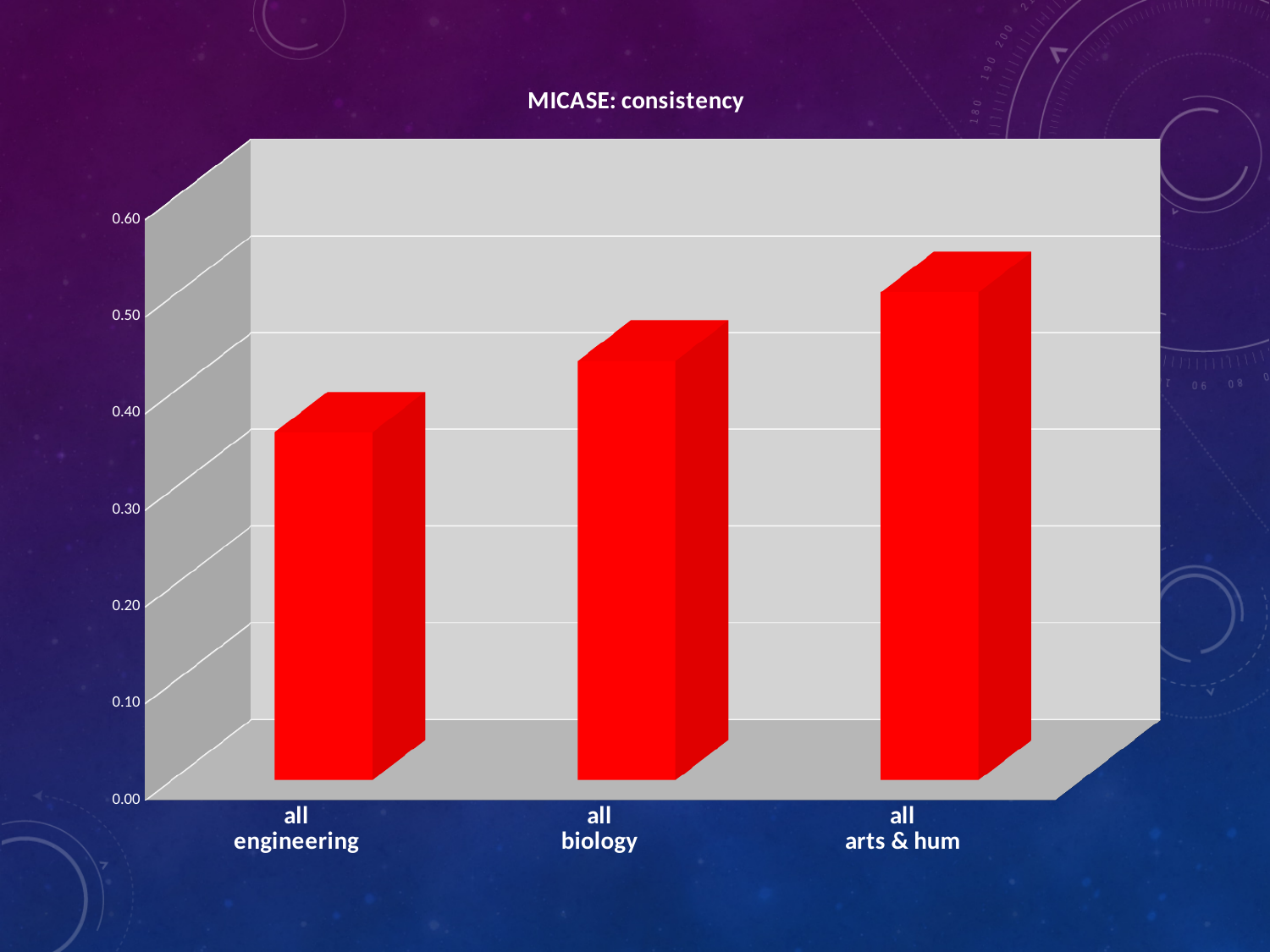
Is the value for all arts & hum greater or less than 0.60? less Which is larger, the value for all biology or the value for all engineering? all biology Which category has the lowest value? all engineering Is the value for all biology greater or less than 0.40? greater What kind of chart is shown on the slide? bar chart Is the value for all engineering greater or less than 0.30? greater What is the title of the chart? MICASE: consistency How many categories are plotted in the chart? 3 Which category has the highest value? all arts & hum Do the values rise or fall from left to right across the categories? rise What colour are the bars in the chart? red Which is larger, the value for all arts & hum or the value for all biology? all arts & hum